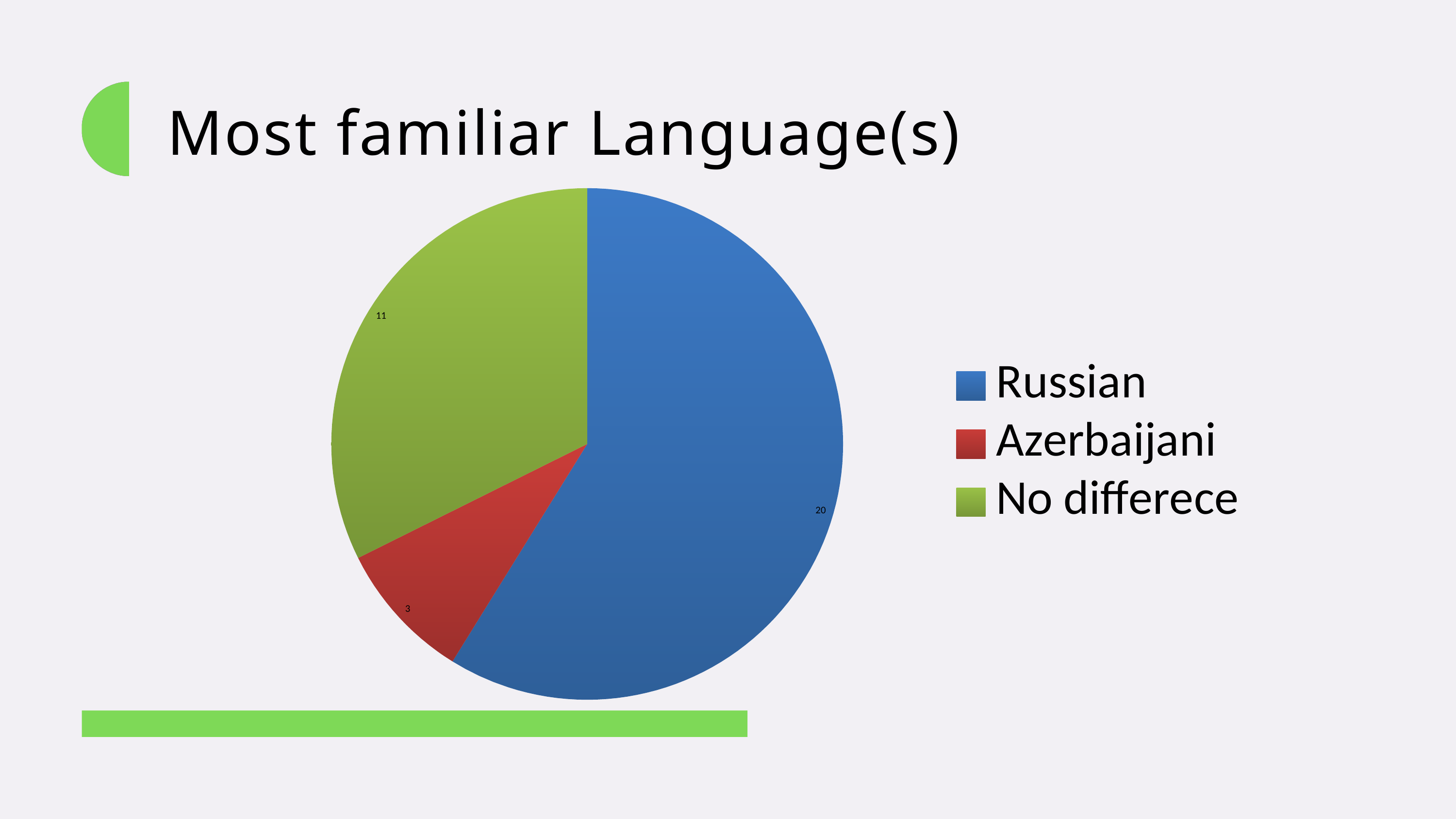
What is the value for Russian? 20 What is the value for Azerbaijani? 3 Which category has the smallest slice? Azerbaijani What is the value for No differece? 11 What kind of chart is shown on the slide? pie chart What is the difference between the values for Russian and No differece? 9 How many categories does the pie chart have? 3 What colour is the slice for Azerbaijani? red What is the total of all slices in the pie chart? 34 Which is larger, the value for Russian or the value for No differece? Russian Which category has the largest slice? Russian What is the difference between the values for No differece and Azerbaijani? 8